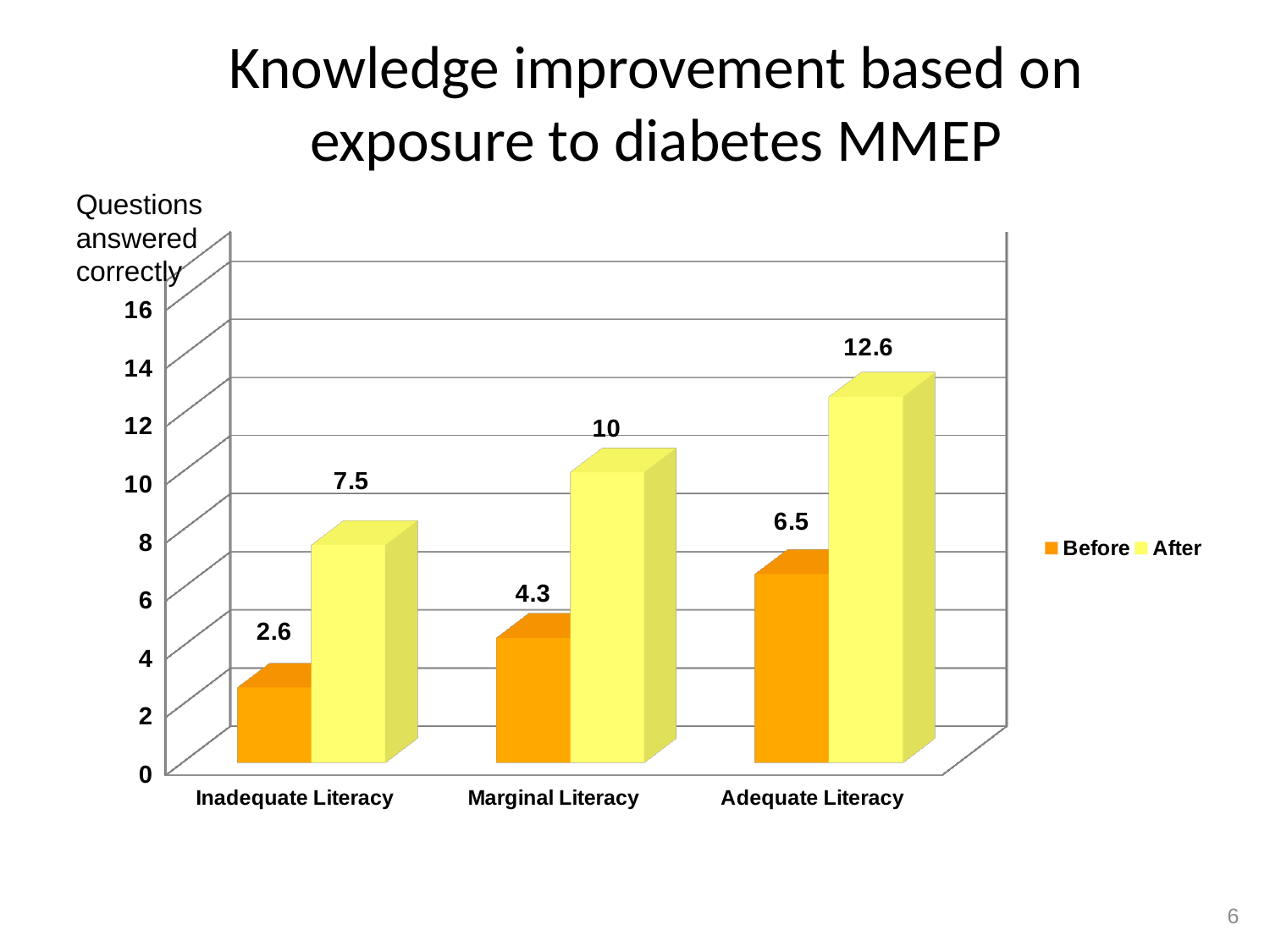
How many literacy categories are shown on the x axis? 3 Which literacy category has the highest After value? Adequate Literacy What is the After value for Marginal Literacy? 10 What is the difference between the After values for Adequate Literacy and Inadequate Literacy? 5.1 How many series does the legend list? 2 What is the difference between the After and Before values for Marginal Literacy? 5.7 Do the Before values rise or fall from Inadequate Literacy to Adequate Literacy? Rise What is the After value for Adequate Literacy? 12.6 What kind of chart is shown on the slide? Bar chart Which is larger: the Before value for Adequate Literacy or the After value for Inadequate Literacy? After value for Inadequate Literacy Which literacy category has the lowest Before value? Inadequate Literacy What is the Before value for Inadequate Literacy? 2.6